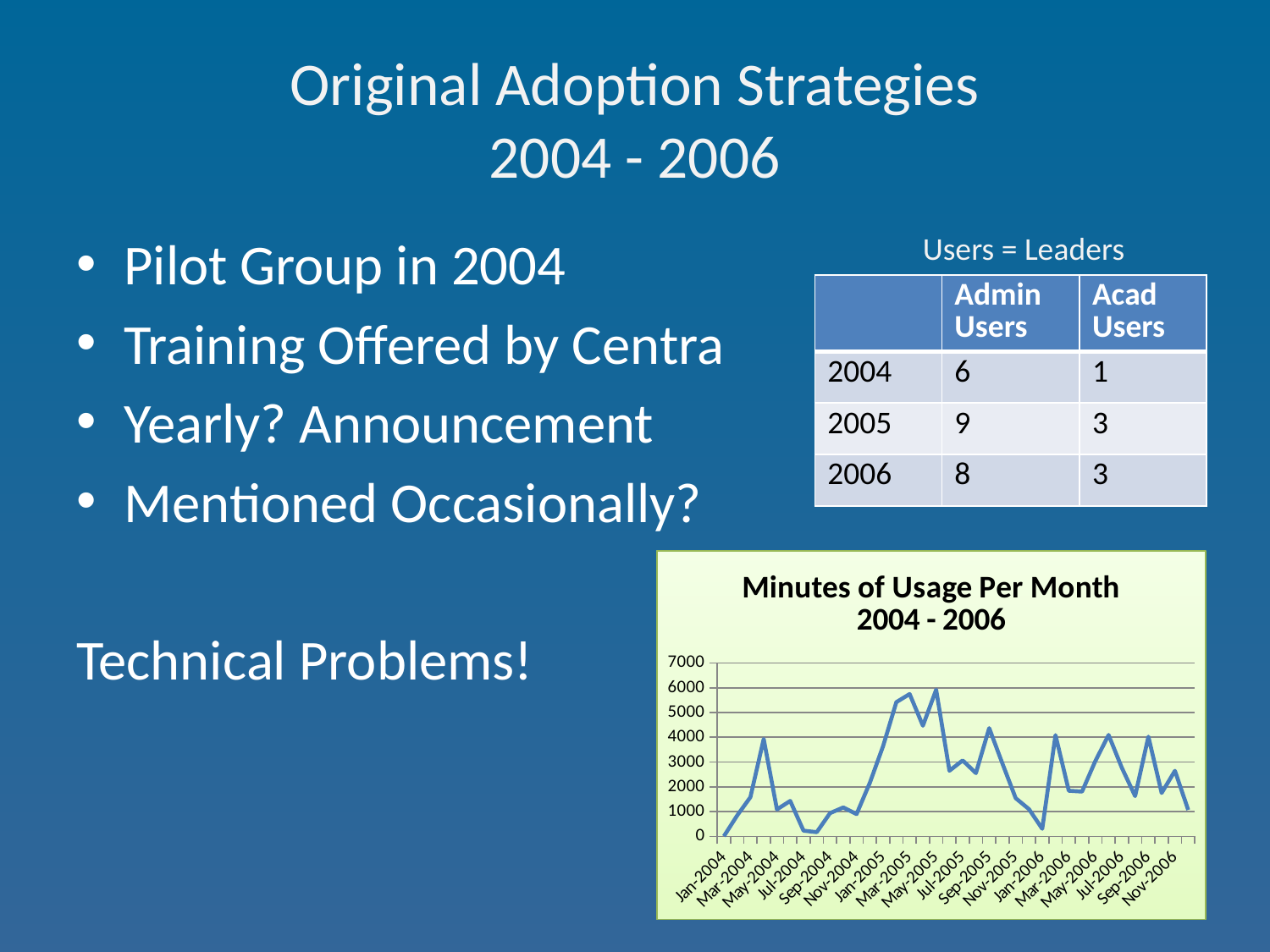
Which is larger, the value for Mar-2005 or the value for Jul-2005? Mar-2005 What is the title of the chart on the slide? Minutes of Usage Per Month 2004 - 2006 Is the value for May-2004 greater or less than 3000? less Is the value for Jan-2004 greater or less than 1000? less Is the value for Mar-2005 greater or less than 5000? greater What is the highest value shown on the chart's vertical axis? 7000 Which is larger, the value for May-2004 or the value for Jan-2004? May-2004 What kind of chart is shown on the slide? line chart